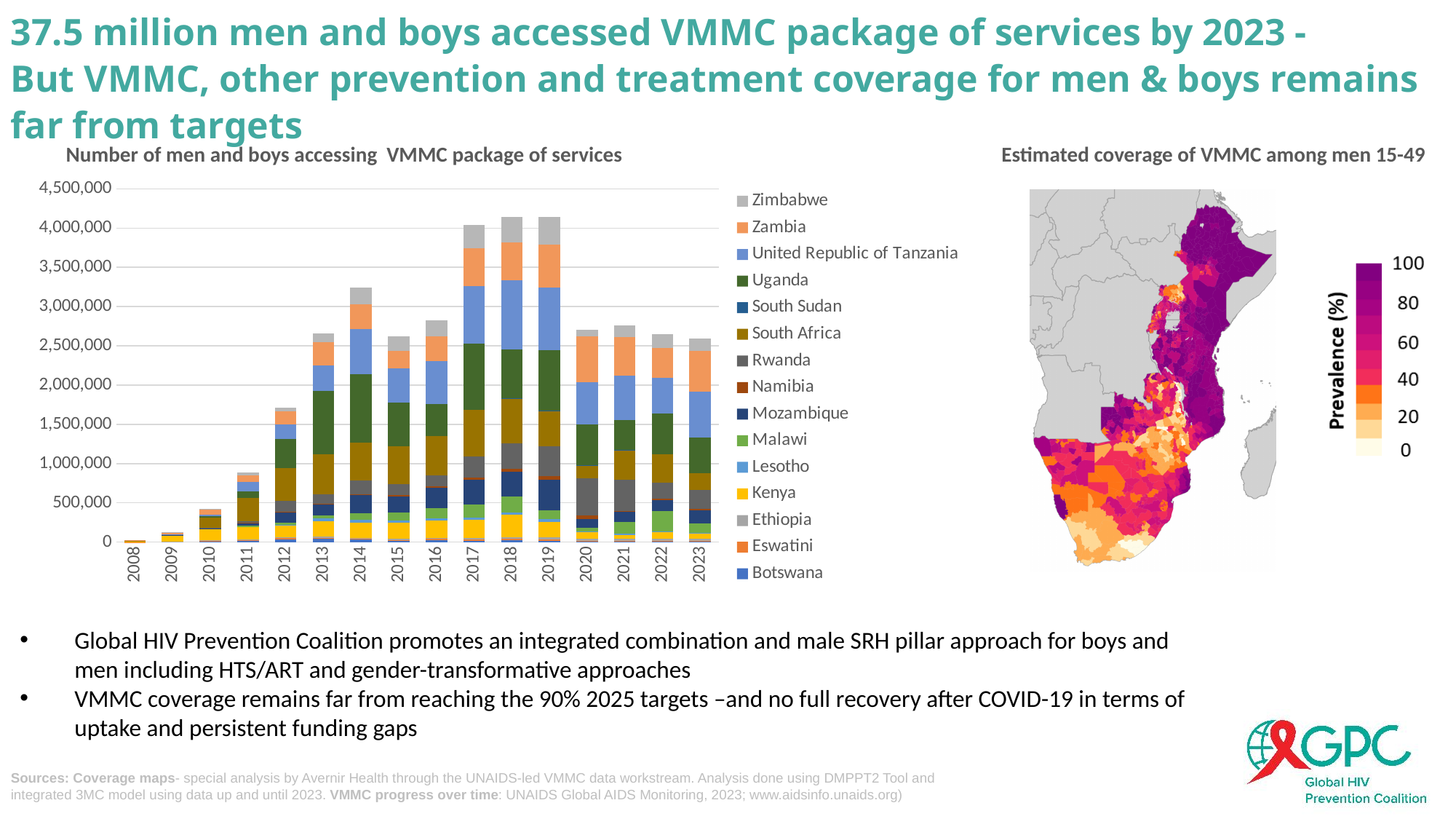
In the chart 'Number of men and boys accessing VMMC package of services', do the total bars rise or fall from 2008 to 2014? Rise In the chart 'Number of men and boys accessing VMMC package of services', is the total for 2012 greater or less than 2,000,000? less In the chart 'Number of men and boys accessing VMMC package of services', is the total for 2023 greater or less than 3,000,000? less In the chart 'Number of men and boys accessing VMMC package of services', which year has the larger total bar, 2018 or 2020? 2018 In the chart 'Number of men and boys accessing VMMC package of services', is the total for 2014 greater or less than 3,000,000? greater In the chart 'Number of men and boys accessing VMMC package of services', which year has the lowest total bar? 2008 What kind of chart is 'Number of men and boys accessing VMMC package of services'? Stacked bar chart What is the title of the map on the right side of the slide? Estimated coverage of VMMC among men 15-49 In the chart 'Number of men and boys accessing VMMC package of services', how many years are shown on the x axis? 16 In the chart 'Number of men and boys accessing VMMC package of services', which year has the larger total bar, 2014 or 2015? 2014 How many countries does the legend of the chart 'Number of men and boys accessing VMMC package of services' list? 15